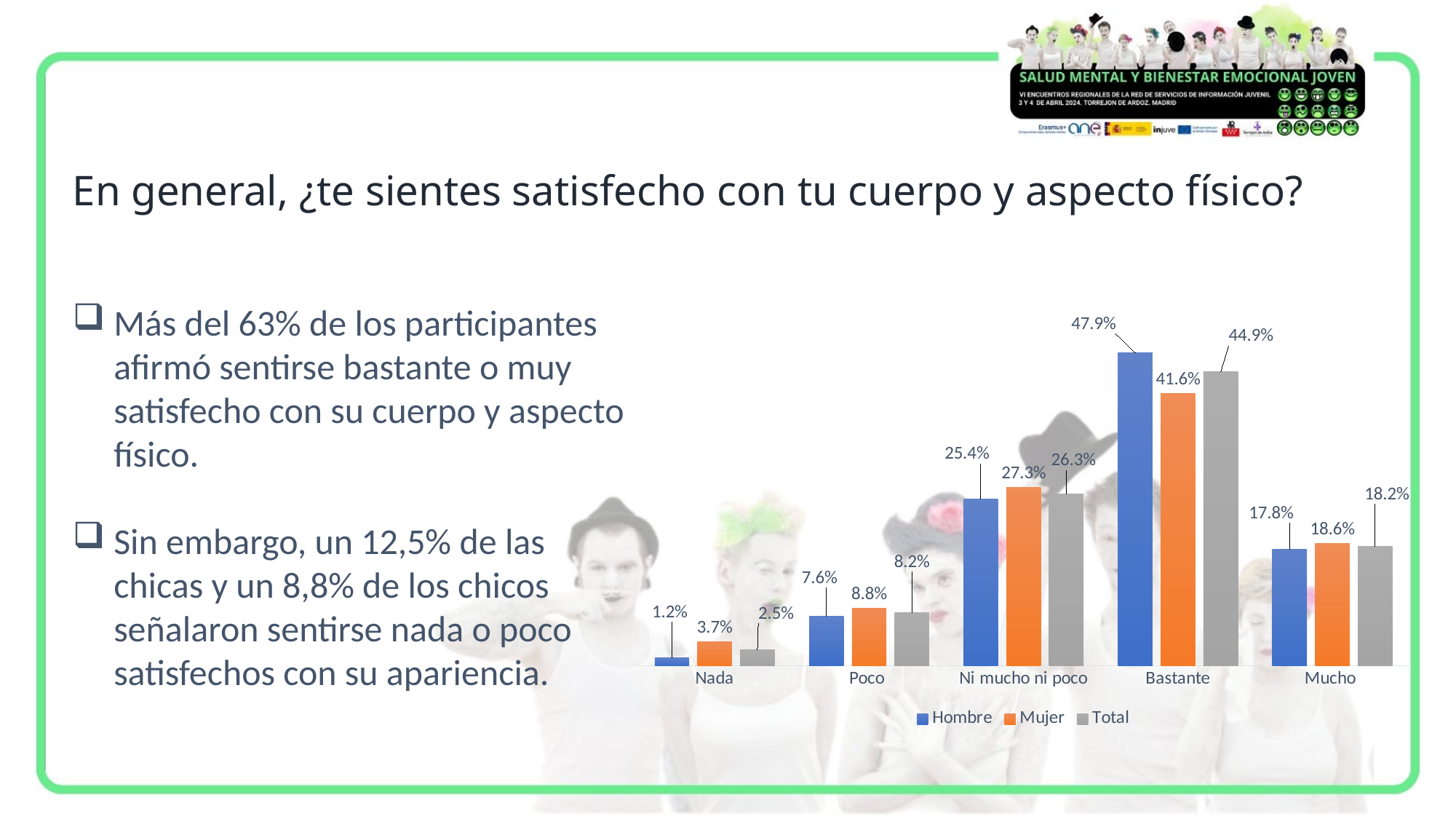
What kind of chart is shown on the slide? Bar chart Which category has the highest Total value? Bastante What is the Mujer value for Nada? 3.7% What is the Mujer value for Mucho? 18.6% Which category has the lowest Hombre value? Nada What is the Hombre value for Bastante? 47.9% For Poco, which is larger, the Hombre value or the Mujer value? Mujer What is the Total value for Ni mucho ni poco? 26.3% How many series does the legend list? 3 How many categories are shown on the x axis? 5 Which series is shown in orange in the legend? Mujer What is the difference between the Hombre and Mujer values for Bastante? 6.3%